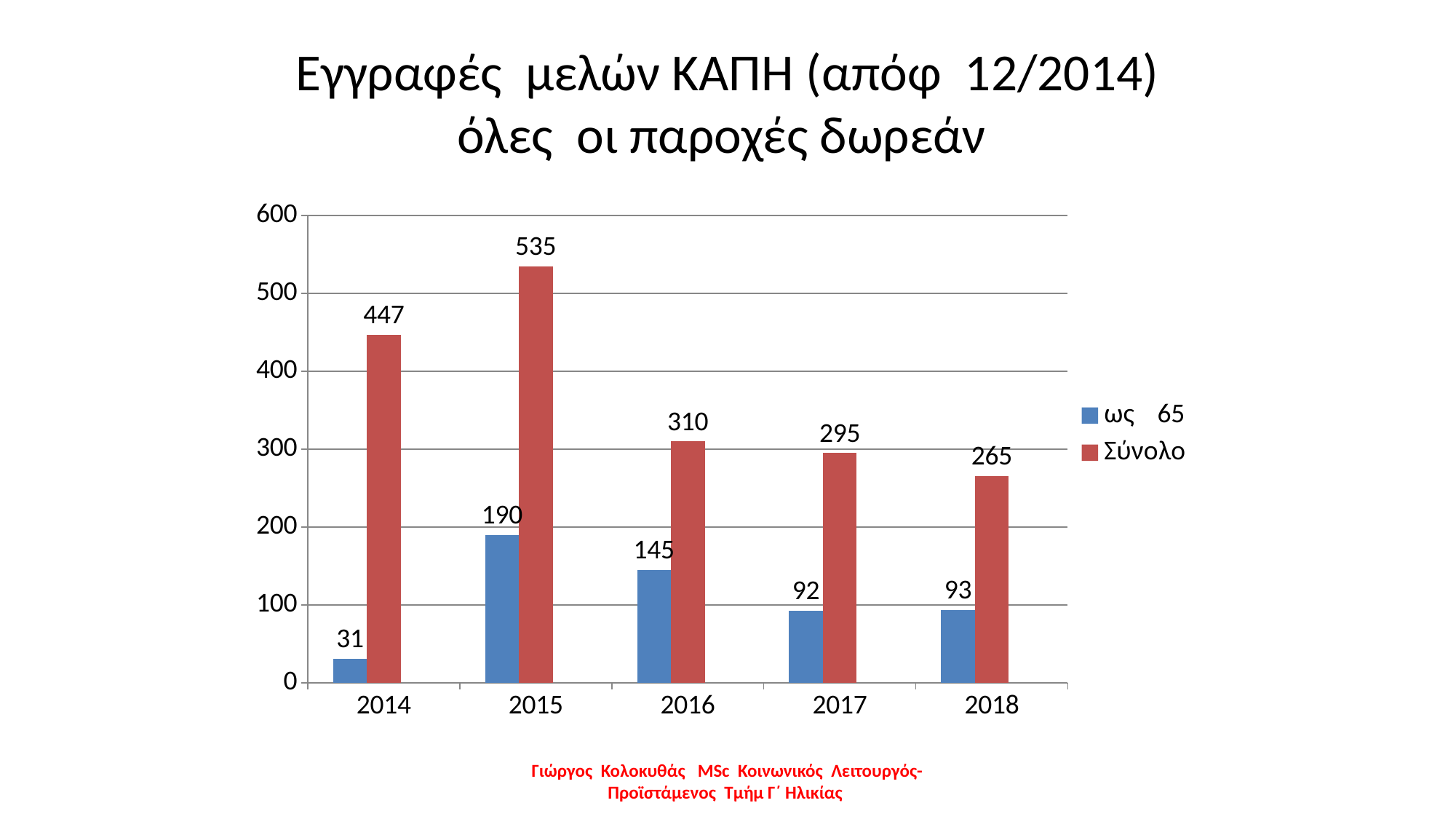
What is the difference between the Σύνολο and ως 65 values for 2016? 165 What is the Σύνολο value for 2015? 535 What is the difference between the Σύνολο values for 2015 and 2014? 88 How many series does the legend list? 2 What is the ως 65 value for 2014? 31 What is the ως 65 value for 2017? 92 What kind of chart is shown on the slide? Bar chart Which year has the highest Σύνολο value? 2015 Do the Σύνολο values rise or fall from 2015 to 2018? Fall Which year has the lowest ως 65 value? 2014 How many years are shown on the x axis? 5 Which is larger, the Σύνολο value for 2017 or for 2018? 2017